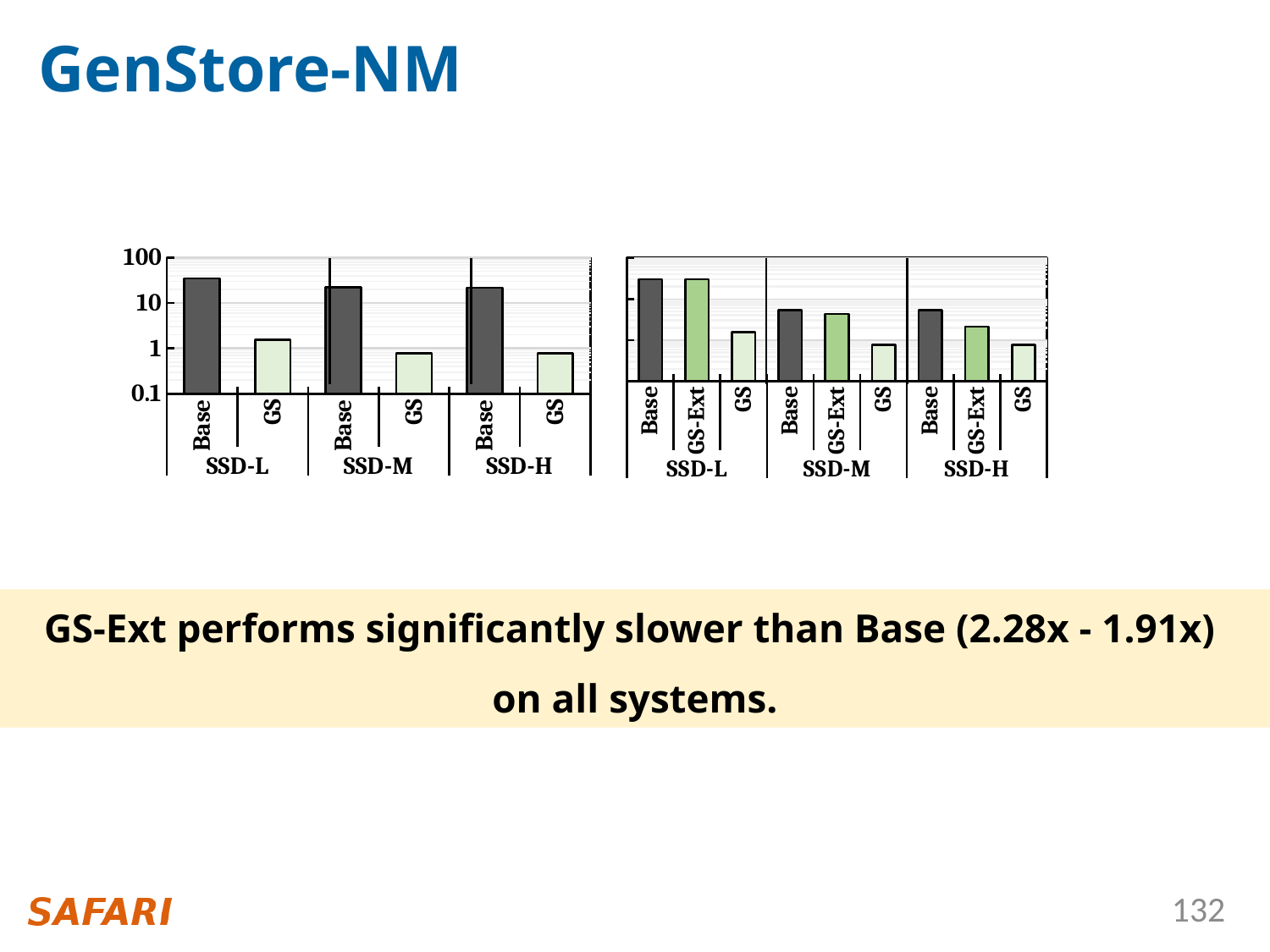
In the right chart, how many bars are plotted in total? 9 In the left chart, is the GS value for SSD-M greater or less than 1? less In the left chart, is the Base value for SSD-L greater or less than 10? greater In the right chart, which is larger for SSD-M: GS-Ext or GS? GS-Ext In the left chart, is the Base value for SSD-H greater or less than 100? less In the left chart, how many bars are plotted in total? 6 In the left chart, how many SSD groups (SSD-L, SSD-M, SSD-H) are shown on the x axis? 3 What kind of chart is the left chart on the slide? bar chart In the left chart, which is larger for SSD-M: Base or GS? Base In the left chart, which bar is the highest? Base for SSD-L In the right chart, which is larger for SSD-H: Base or GS? Base